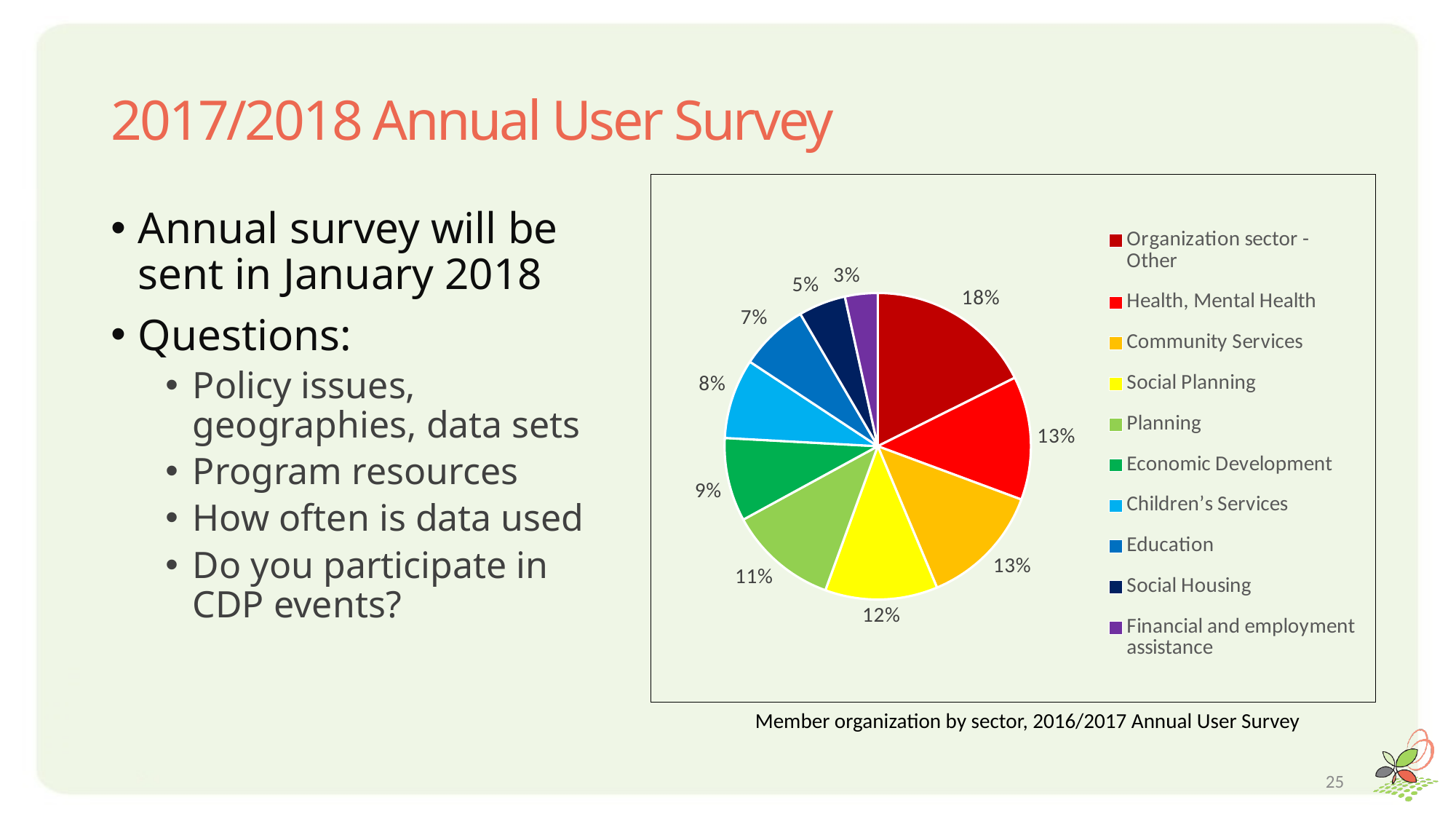
How many sectors are listed in the legend? 10 What share of the pie does Financial and employment assistance represent? 3% What kind of chart is shown on the slide? Pie chart Which is larger, the slice for Economic Development or the slice for Children's Services? Economic Development Which sector has the smallest slice of the pie? Financial and employment assistance What share of the pie does Social Planning represent? 12% What is the caption below the chart? Member organization by sector, 2016/2017 Annual User Survey What share of the pie does Education represent? 7% What is the difference in percentage points between Planning and Social Housing? 6 Which sector has the largest slice of the pie? Organization sector - Other What colour is the slice for Social Planning? Yellow